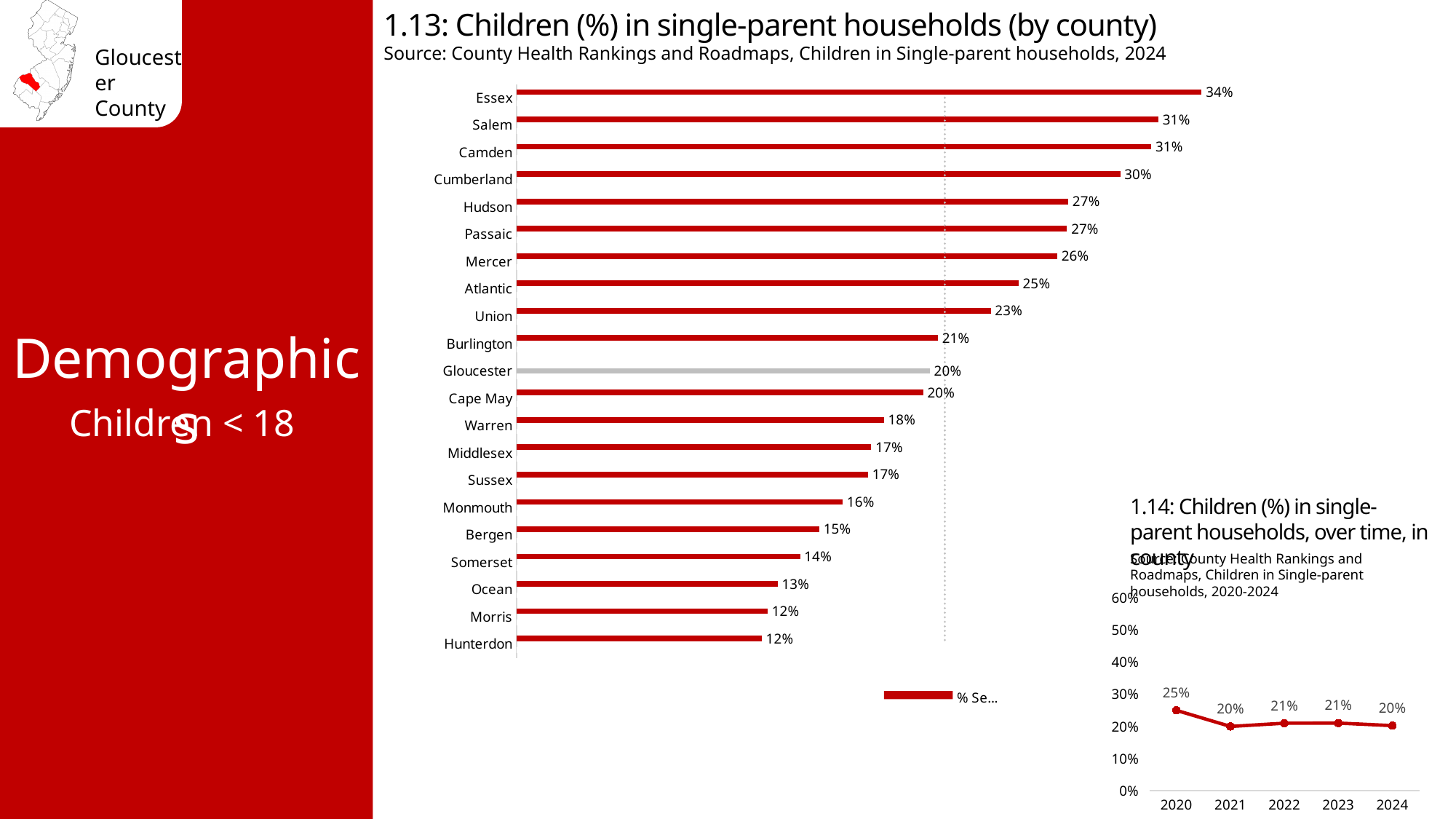
In chart 1.14, how many years are plotted? 5 In chart 1.13 (Children (%) in single-parent households by county), what is the value for Gloucester? 20% In chart 1.13, what is the difference between the values for Essex and Hunterdon? 22% In chart 1.13, what is the value for Monmouth? 16% In chart 1.14, which year has the highest value? 2020 What kind of chart is chart 1.14? Line chart What kind of chart is chart 1.13? Bar chart In chart 1.13, how many counties are shown? 21 In chart 1.13, what is the value for Cumberland? 30% In chart 1.13, which is larger, the value for Atlantic or the value for Union? Atlantic In chart 1.14 (Children (%) in single-parent households over time), what is the value for 2020? 25% In chart 1.13, which county has the highest percentage of children in single-parent households? Essex